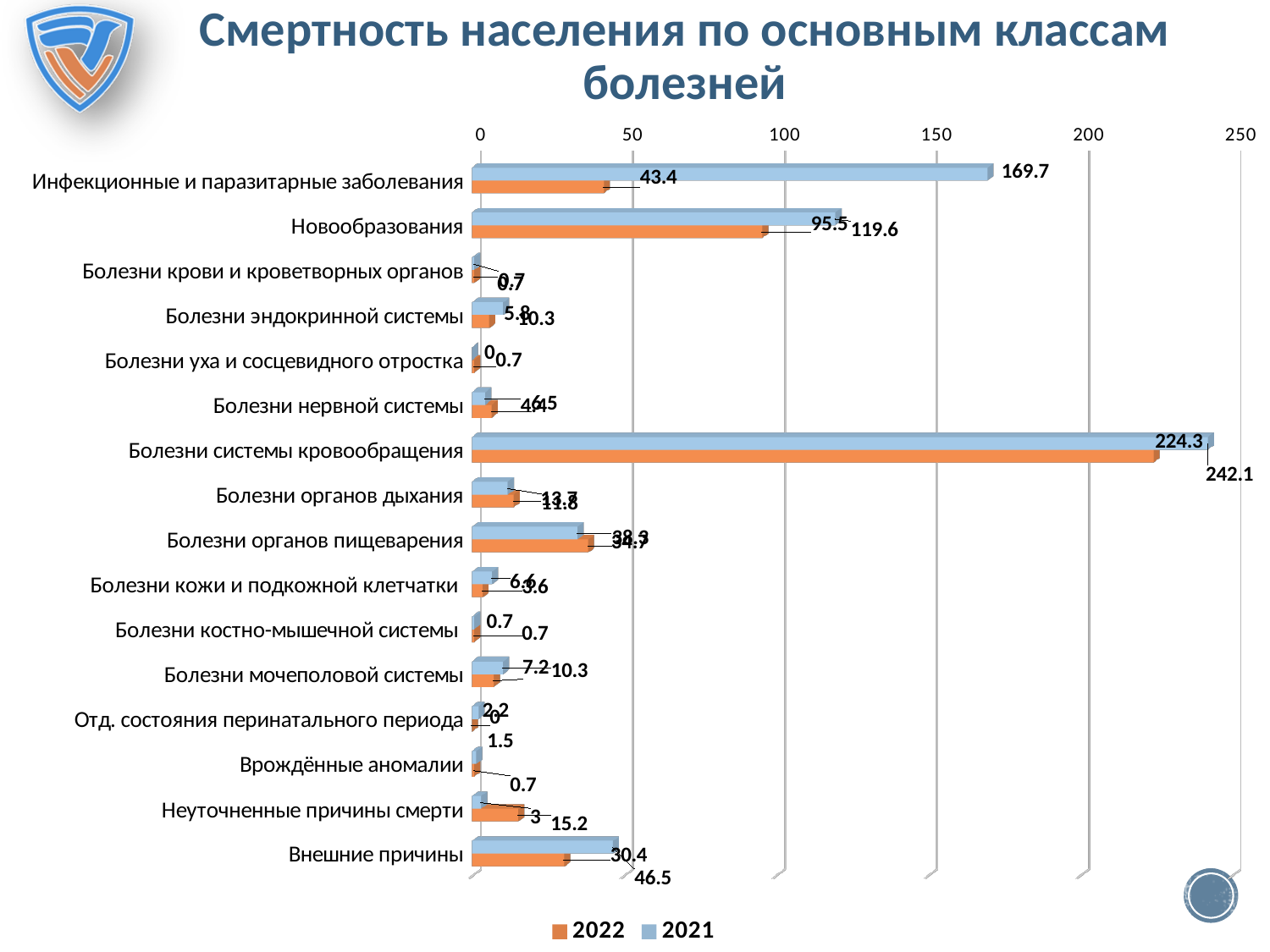
What is the difference between the 2021 and 2022 values for Инфекционные и паразитарные заболевания? 126.3 How many series does the legend list? 2 Which colour represents the 2022 series in the legend? Orange Which disease class has the highest value in 2021? Болезни системы кровообращения What is the 2021 value for Инфекционные и паразитарные заболевания? 169.7 What is the 2022 value for Новообразования? 95.5 For Новообразования, which year has the larger value, 2021 or 2022? 2021 How many disease classes (categories) are shown on the chart? 16 What is the 2022 value for Инфекционные и паразитарные заболевания? 43.4 Is the 2021 value for Болезни системы кровообращения greater or less than 200? greater What is the 2021 value for Новообразования? 119.6 What type of chart is shown on the slide? Bar chart